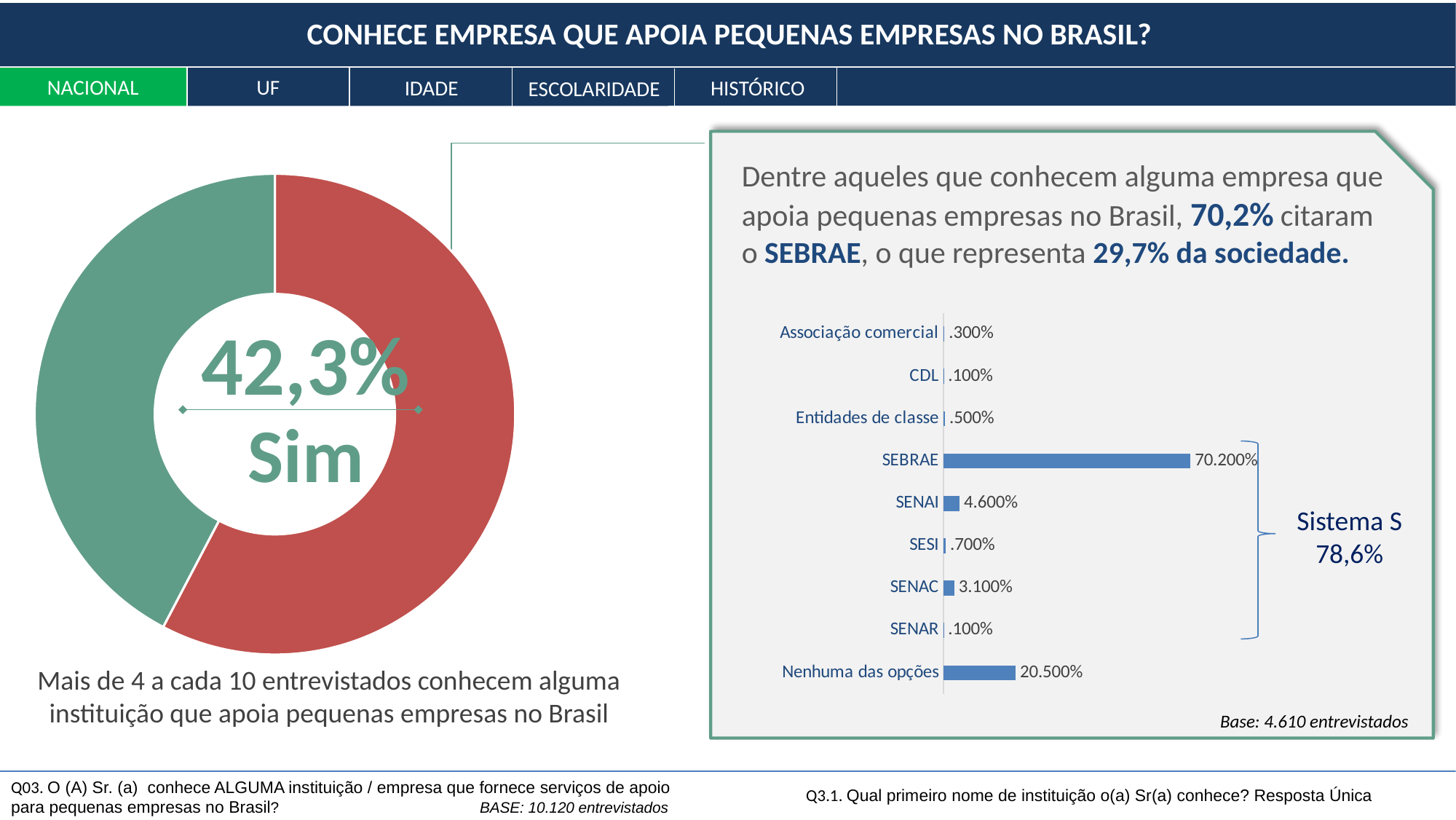
In the bar chart on the right, which is larger, the value for SENAI or the value for SENAC? SENAI How many categories are shown in the bar chart on the right? 9 In the chart on the left, what share of respondents answered Sim? 42,3% In the bar chart on the right, what is the difference between the values for SEBRAE and Nenhuma das opções? 49.700% In the bar chart on the right, what is the value for SESI? .700% In the bar chart on the right, what is the value for SENAI? 4.600% What kind of chart is the chart on the right side of the slide? bar chart In the bar chart on the right, what is the difference between the values for SENAI and SENAC? 1.500% In the bar chart on the right, which category has the highest value? SEBRAE In the bar chart on the right, what is the value for SEBRAE? 70.200% In the bar chart on the right, what is the value for Nenhuma das opções? 20.500% In the bar chart on the right, what percentage is shown for the Sistema S group? 78,6%